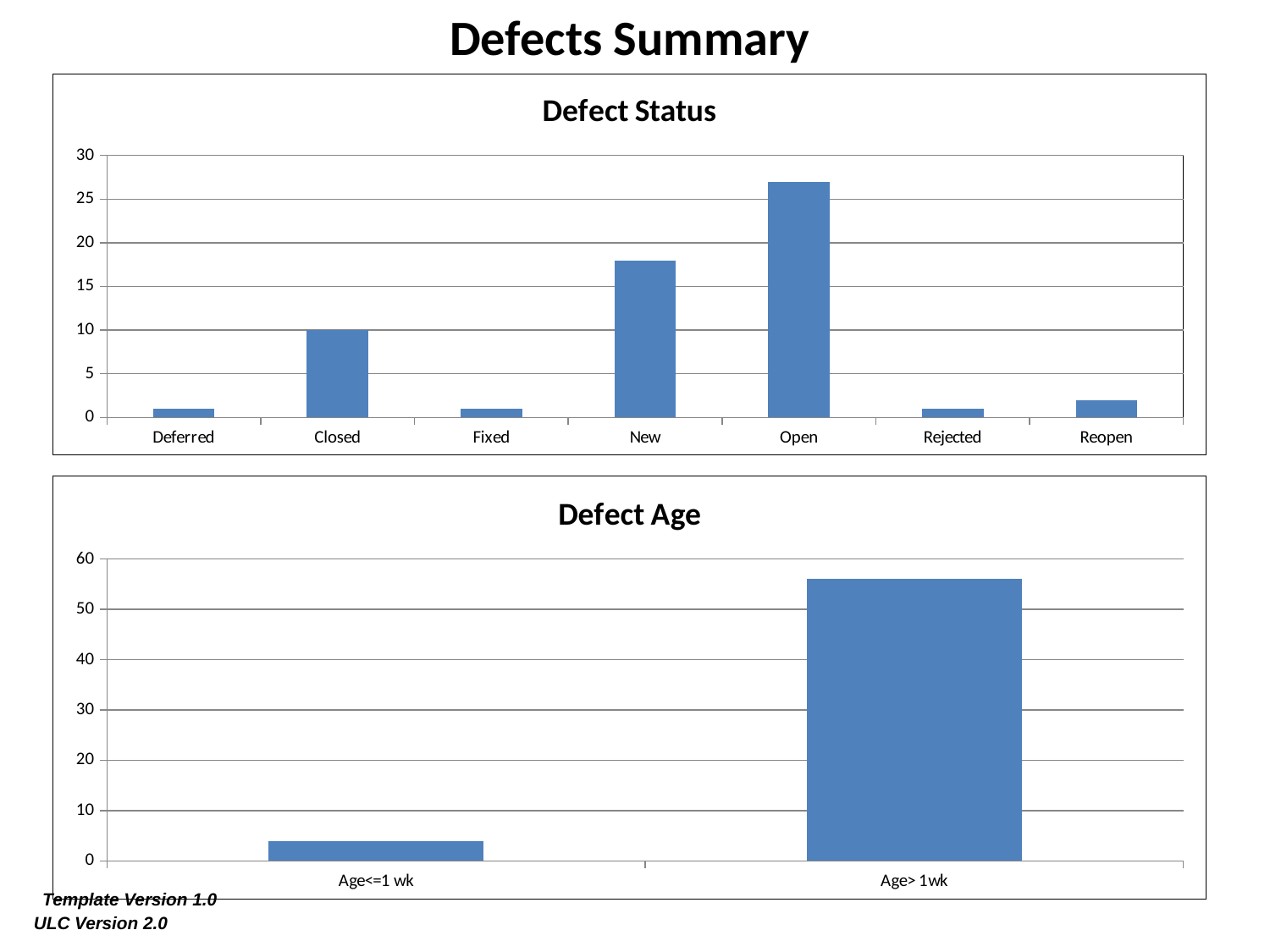
In the Defect Status chart, which category has the highest value? Open In the Defect Status chart, what is the value for Closed? 10 In the Defect Status chart, is the value for Open greater or less than 25? greater In the Defect Status chart, is the value for Reopen greater or less than 5? less How many categories are shown in the Defect Status chart? 7 How many categories are shown in the Defect Age chart? 2 In the Defect Status chart, is the value for New greater or less than 20? less In the Defect Age chart, which category has the highest value? Age> 1wk In the Defect Status chart, which is larger, New or Closed? New What kind of chart is the Defect Status chart? bar chart